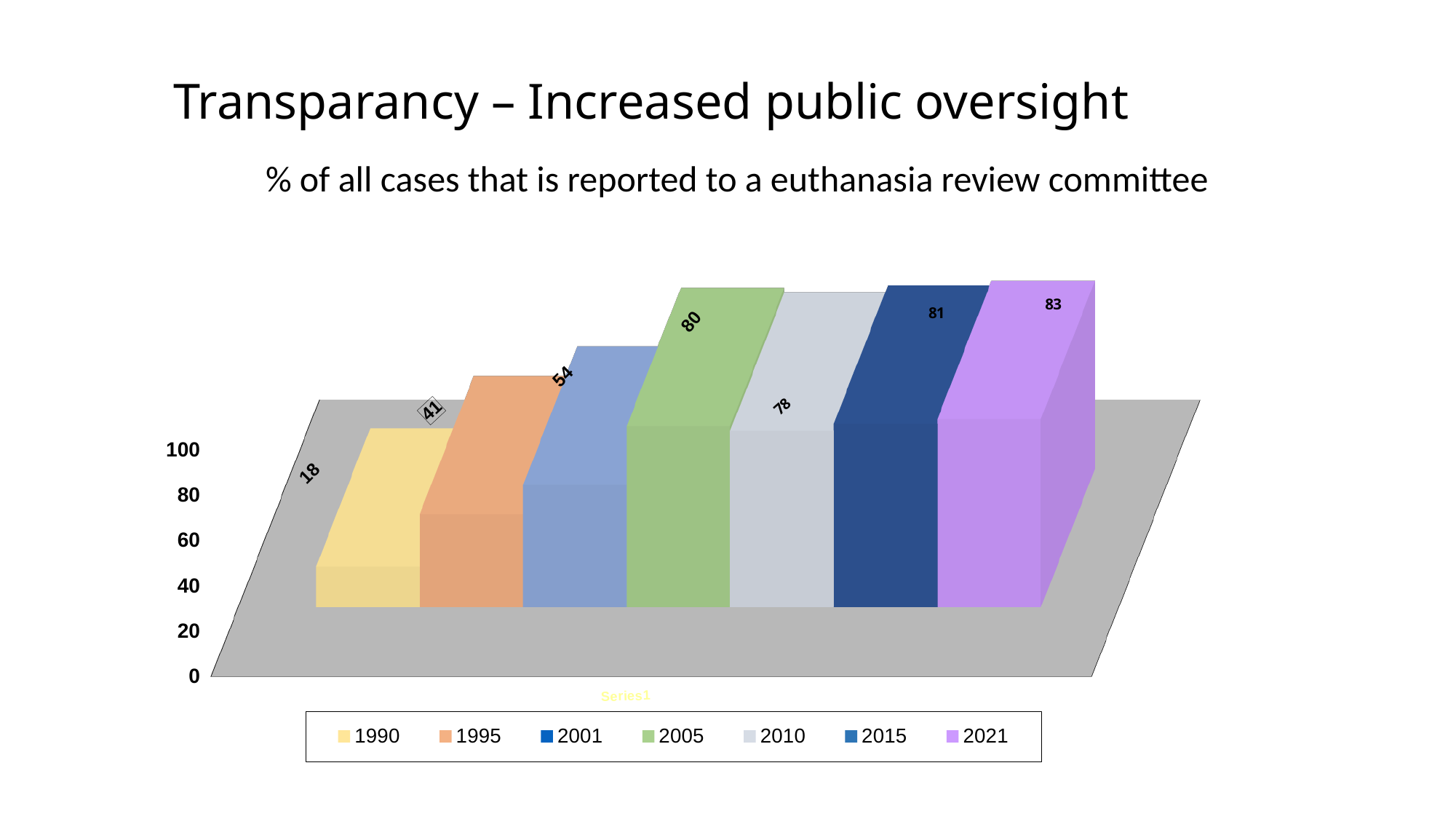
What is the value for 2021? 83 Which is larger, the value for 2005 or the value for 2010? 2005 What kind of chart is shown on the slide? bar chart Which year has the highest value? 2021 What is the difference between the values for 1995 and 1990? 23 Is the value for 2001 greater or less than 60? less What is the value for 1990? 18 What is the value for 2010? 78 How many years are shown in the chart? 7 Which year has the lowest value? 1990 What is the value for 2005? 80 What is the title of the chart? % of all cases that is reported to a euthanasia review committee